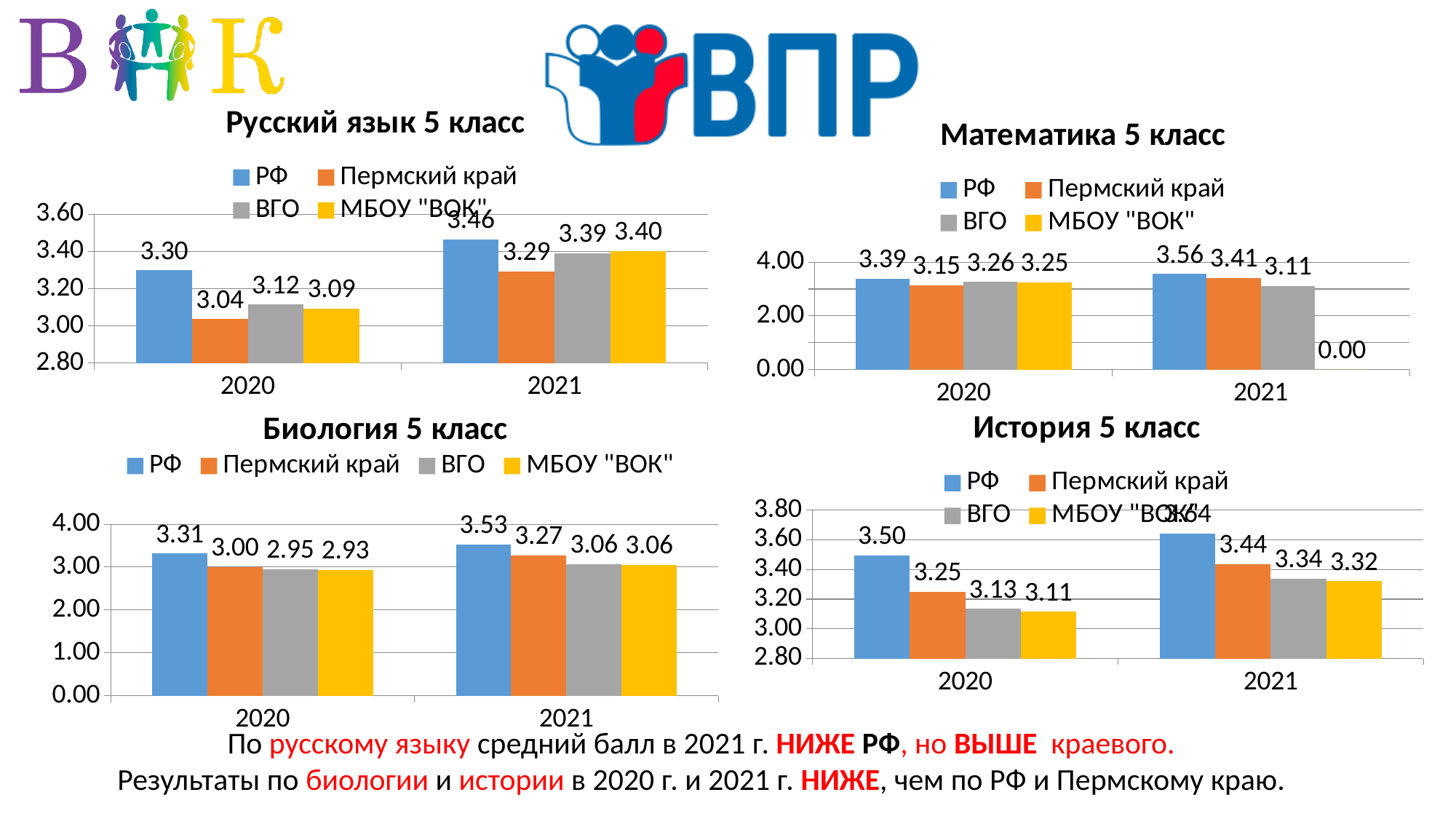
In the chart titled "Биология 5 класс", which series has the highest value in 2021? РФ In the chart titled "Математика 5 класс", how many series does the legend list? 4 In the chart titled "Биология 5 класс", does the value for РФ rise or fall from 2020 to 2021? rise In the chart titled "Математика 5 класс", which series has the lowest value in 2021? МБОУ "ВОК" In the chart titled "Биология 5 класс", what is the value for Пермский край in 2020? 3.00 In the chart titled "Русский язык 5 класс", what is the value for РФ in 2020? 3.30 What kind of chart is the chart titled "История 5 класс"? bar chart In the chart titled "История 5 класс", which is larger in 2020: the value for ВГО or the value for МБОУ "ВОК"? ВГО In the chart titled "Русский язык 5 класс", what is the value for МБОУ "ВОК" in 2021? 3.40 In the chart titled "Математика 5 класс", what is the value for ВГО in 2021? 3.11 In the chart titled "Русский язык 5 класс", what is the difference between the РФ value and the Пермский край value in 2021? 0.17 In the chart titled "История 5 класс", what is the value for Пермский край in 2021? 3.44